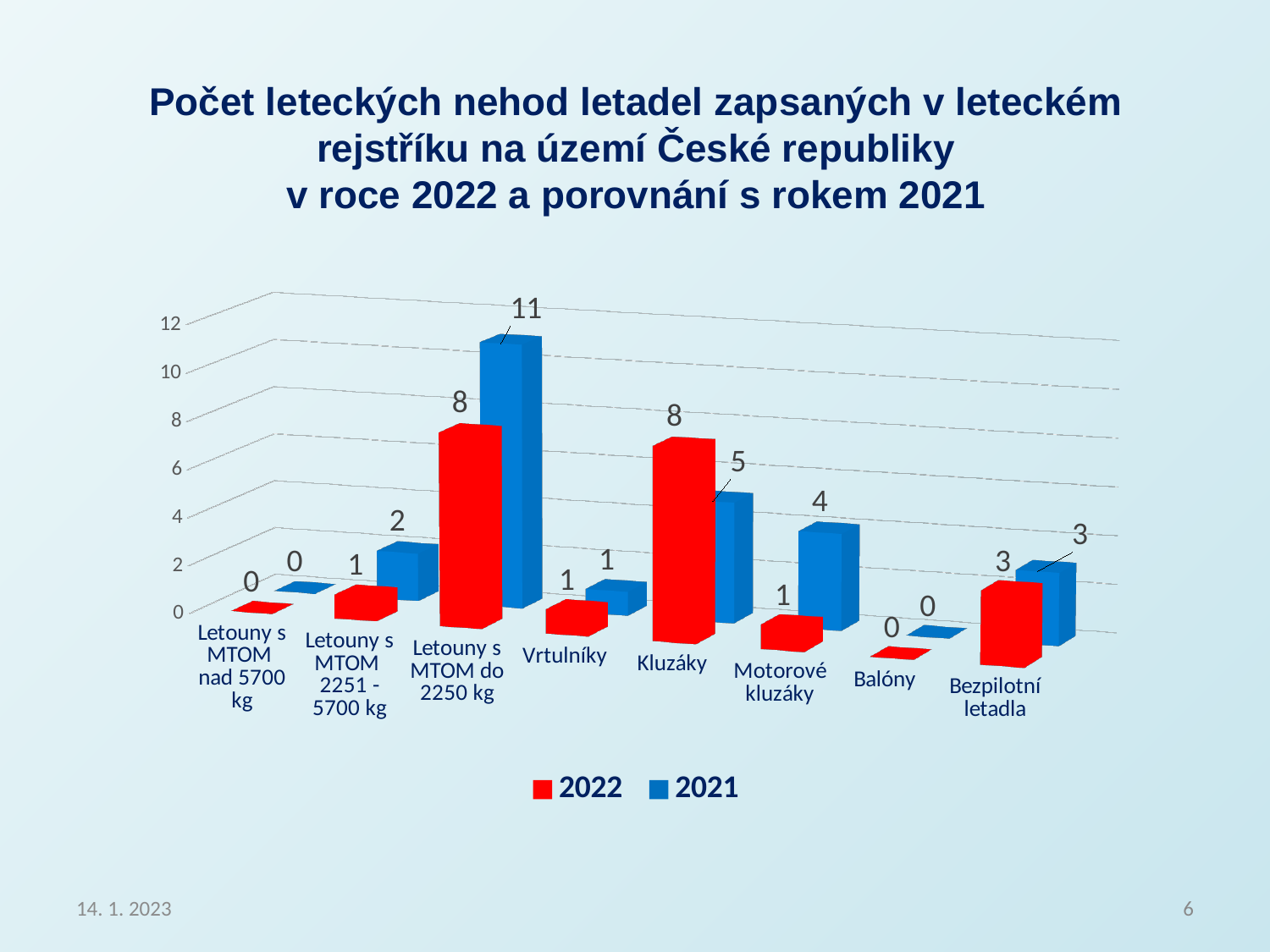
Which colour represents the 2022 series in the legend? red Which category has the highest value in the 2021 series? Letouny s MTOM do 2250 kg What is the difference between the 2022 and 2021 values for Kluzáky? 3 What is the value for Kluzáky in the 2022 series? 8 How many series does the legend list? 2 What is the value for Letouny s MTOM do 2250 kg in the 2021 series? 11 What kind of chart is shown on the slide? bar chart What is the value for Motorové kluzáky in the 2021 series? 4 What is the value for Bezpilotní letadla in the 2022 series? 3 Which is larger for Motorové kluzáky, the 2022 value or the 2021 value? 2021 What is the difference between the 2021 and 2022 values for Letouny s MTOM do 2250 kg? 3 How many categories are shown on the x axis? 8